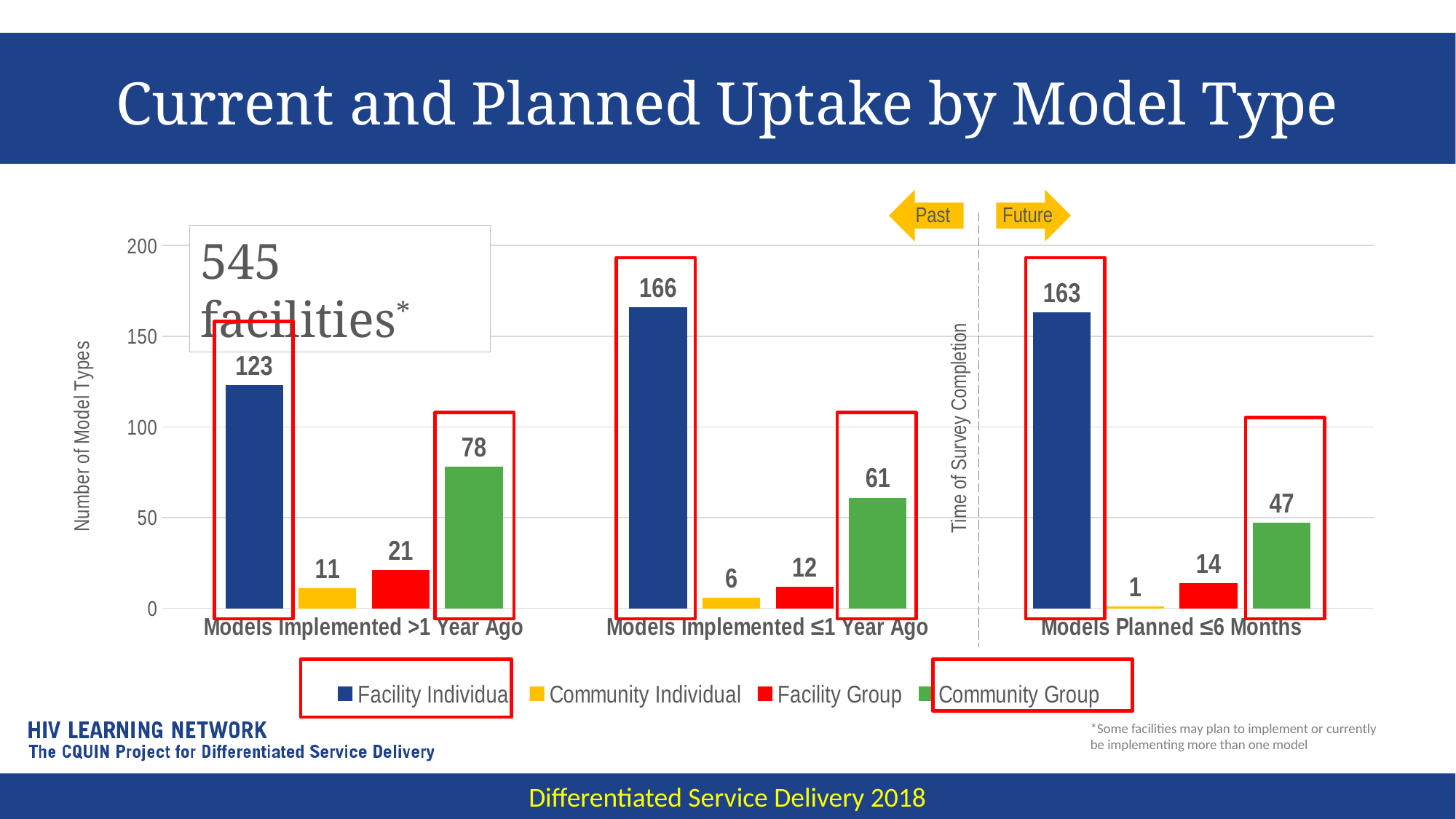
How many categories are shown on the x axis? 3 What is the value for Community Group in the 'Models Planned ≤6 Months' category? 47 How many series does the legend list? 4 Which series has the lowest value in the 'Models Planned ≤6 Months' category? Community Individual Which series has the highest value in the 'Models Implemented ≤1 Year Ago' category? Facility Individual What is the value for Community Individual in the 'Models Implemented ≤1 Year Ago' category? 6 What is the value for Facility Individual in the 'Models Implemented >1 Year Ago' category? 123 Which is larger: Community Group for 'Models Implemented >1 Year Ago' or Community Group for 'Models Implemented ≤1 Year Ago'? Models Implemented >1 Year Ago What is the label of the y axis? Number of Model Types What is the difference between the Facility Individual values for 'Models Implemented ≤1 Year Ago' and 'Models Planned ≤6 Months'? 3 Is the Facility Individual value for 'Models Implemented >1 Year Ago' greater or less than 100? greater What kind of chart is shown on the slide? bar chart